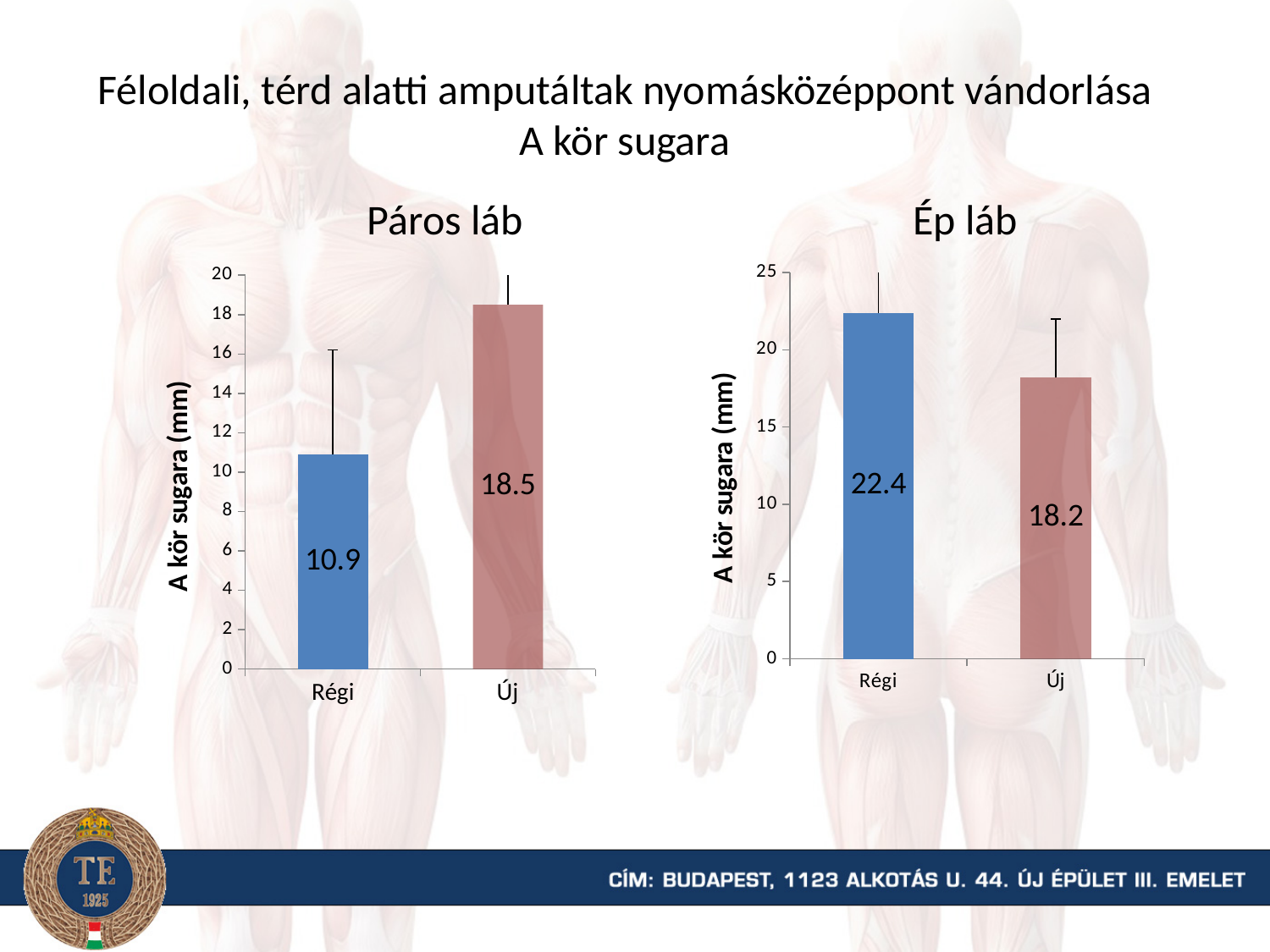
In the 'Ép láb' chart, what is the value for Régi? 22.4 In the 'Ép láb' chart, is the value for Régi greater or less than 20? greater In the 'Ép láb' chart, which category has the lowest value? Új In the 'Páros láb' chart, what is the value for Új? 18.5 In the 'Ép láb' chart, what is the value for Új? 18.2 What kind of chart is the 'Ép láb' chart? bar chart In the 'Páros láb' chart, what is the difference between the values for Új and Régi? 7.6 In the 'Ép láb' chart, what is the difference between the values for Régi and Új? 4.2 In the 'Páros láb' chart, which category has the highest value? Új In the 'Páros láb' chart, what is the value for Régi? 10.9 How many categories are shown in the 'Páros láb' chart? 2 What is the y-axis label of the 'Páros láb' chart? A kör sugara (mm)